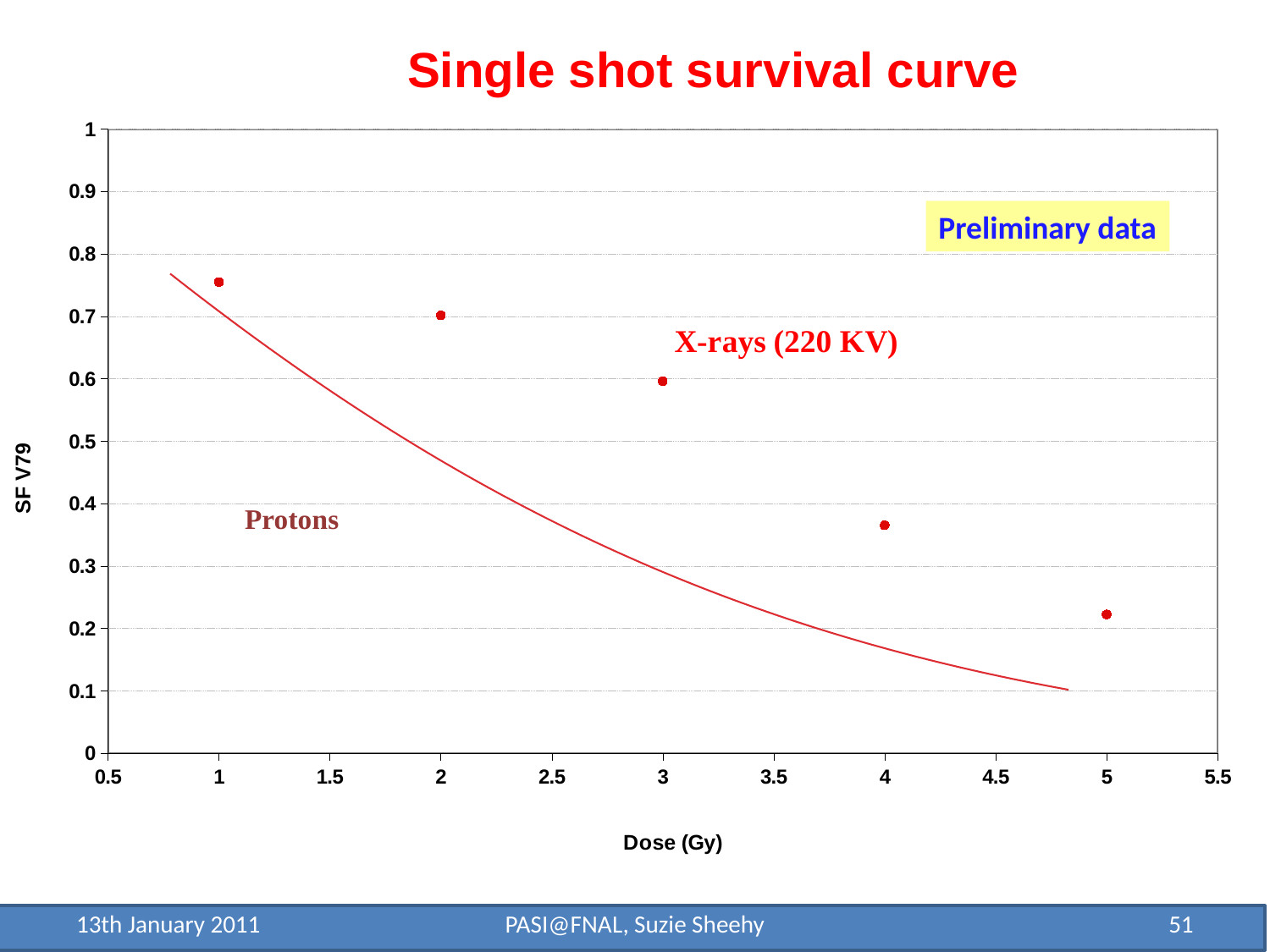
Is the X-rays (220 KV) value at a dose of 5 Gy greater or less than 0.3? less What is the title of the chart? Single shot survival curve Is the X-rays (220 KV) value at a dose of 4 Gy greater or less than 0.4? less At which dose is the X-rays (220 KV) data point lowest? 5 Do the X-rays (220 KV) values rise or fall as dose increases? fall Is the X-rays (220 KV) value at a dose of 1 Gy greater or less than 0.7? greater What kind of chart is shown on the slide? scatter chart At which dose is the X-rays (220 KV) data point highest? 1 What is the label of the x axis? Dose (Gy) At a dose of 3 Gy, which is higher: the X-rays (220 KV) data point or the Protons curve? X-rays (220 KV) How many X-ray data points are plotted on the chart? 5